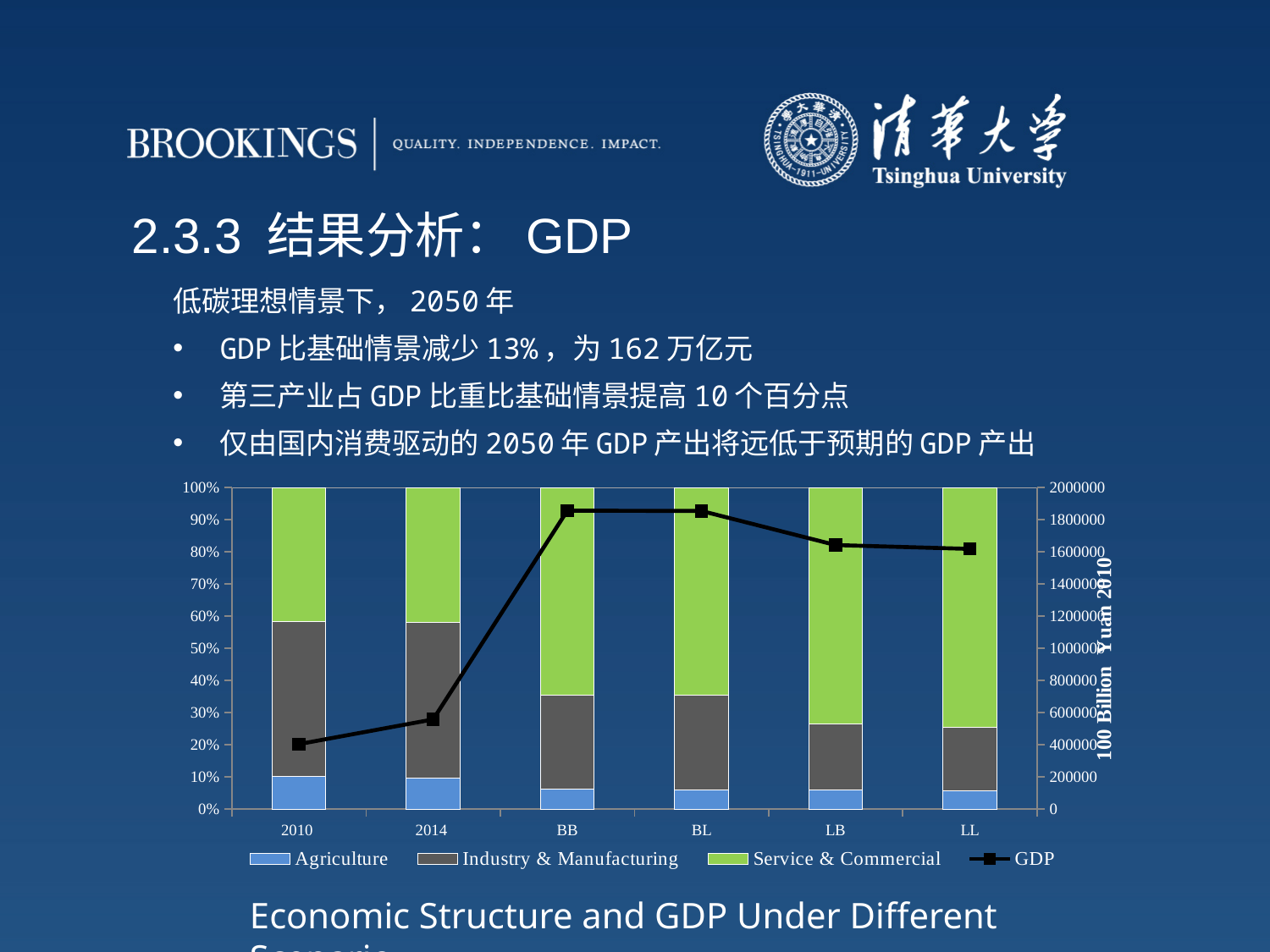
Is the GDP value for LB greater or less than 1800000? less Does the GDP line rise or fall from 2010 to BB? rise What is the label of the right-hand vertical axis? 100 Billion Yuan 2010 Which category has the lowest GDP value on the line? 2010 Is the GDP value for BB greater or less than 1600000? greater How many categories are shown on the x axis of the chart? 6 Is the GDP value for 2010 greater or less than 600000? less How many series does the chart legend list? 4 Which has a larger Service & Commercial share, 2010 or LB? LB Which has a larger Industry & Manufacturing share, 2010 or BB? 2010 What type of chart is shown on the slide? Stacked bar chart with a line